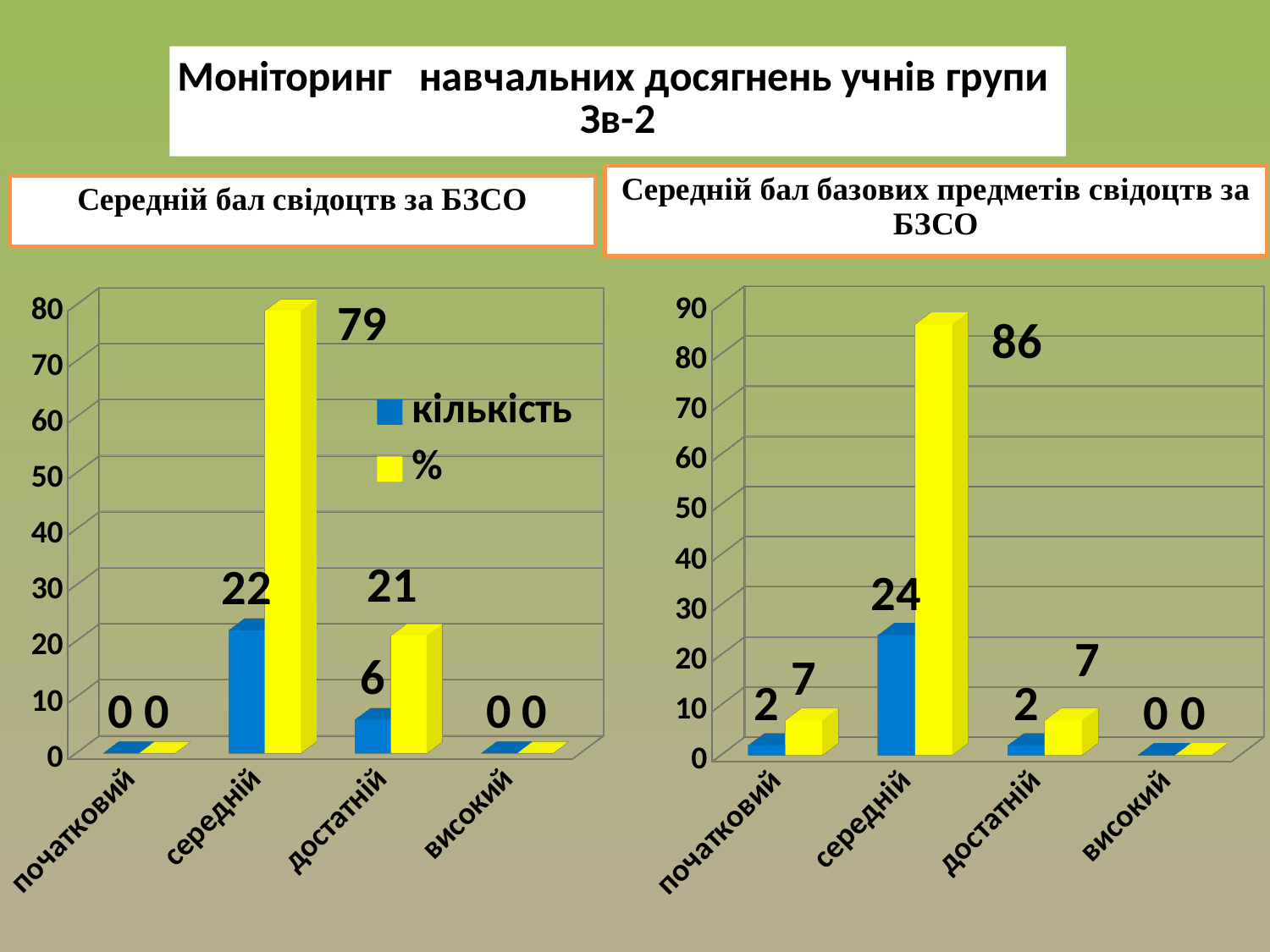
In the right chart 'Середній бал базових предметів свідоцтв за БЗСО', what is the value of the blue bar for 'початковий'? 2 In the left chart 'Середній бал свідоцтв за БЗСО', what is the difference between the '%' values for 'середній' and 'достатній'? 58 In the left chart 'Середній бал свідоцтв за БЗСО', which colour represents the '%' series in the legend? yellow In the left chart 'Середній бал свідоцтв за БЗСО', which category has the highest '%' value? середній In the left chart 'Середній бал свідоцтв за БЗСО', how many categories are shown on the x axis? 4 What type of chart is the right chart 'Середній бал базових предметів свідоцтв за БЗСО'? bar chart In the left chart 'Середній бал свідоцтв за БЗСО', how many series does the legend list? 2 In the left chart 'Середній бал свідоцтв за БЗСО', what is the '%' value for 'достатній'? 21 In the right chart 'Середній бал базових предметів свідоцтв за БЗСО', which is larger: the blue bar for 'середній' or the blue bar for 'достатній'? середній In the right chart 'Середній бал базових предметів свідоцтв за БЗСО', what is the difference between the blue bar values for 'середній' and 'достатній'? 22 In the right chart 'Середній бал базових предметів свідоцтв за БЗСО', what is the value of the yellow bar for 'середній'? 86 In the left chart 'Середній бал свідоцтв за БЗСО', what is the value of 'кількість' for 'середній'? 22